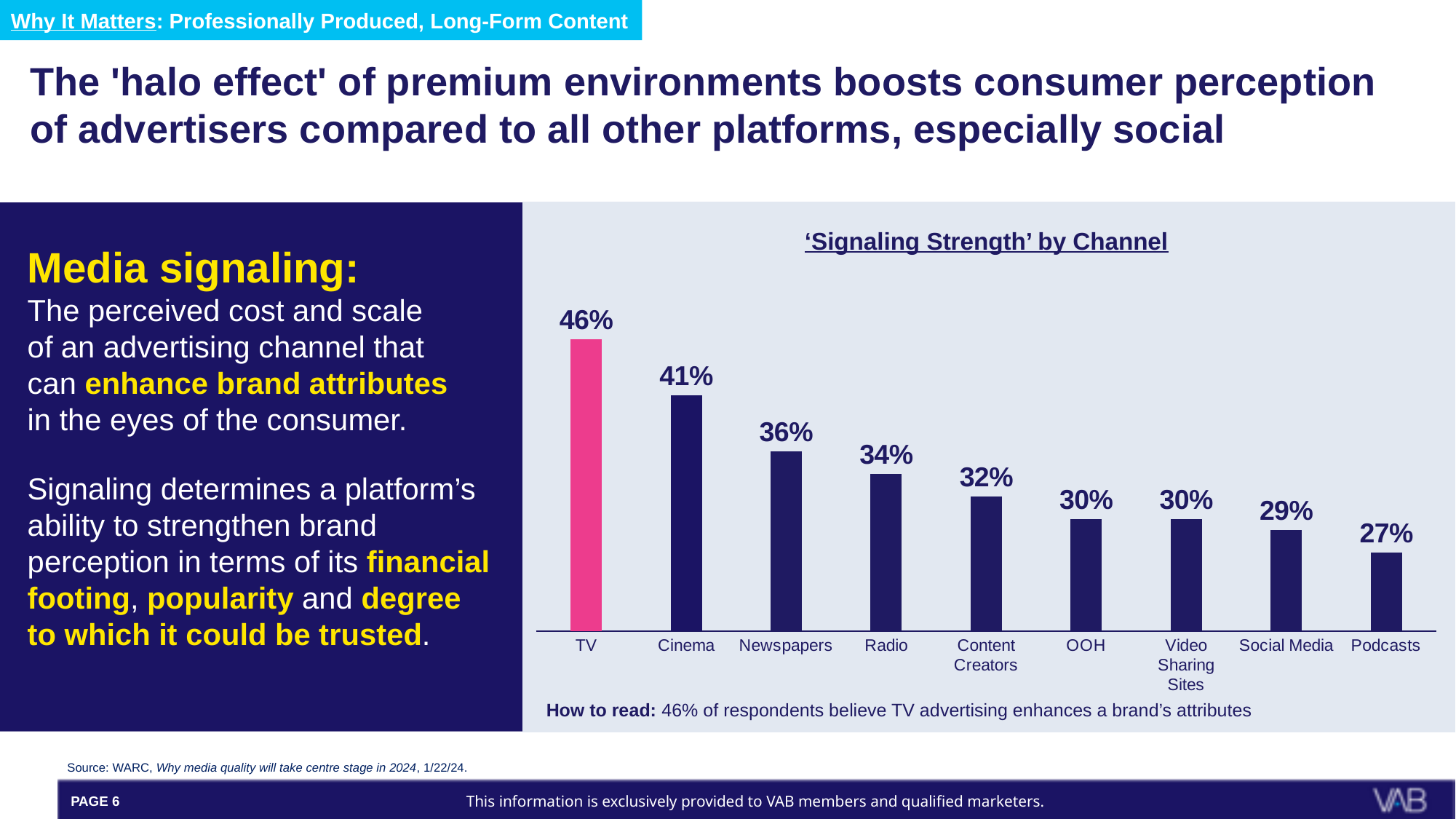
What is the difference in signaling strength between Cinema and Newspapers? 5% What is the signaling strength value for Cinema? 41% What is the signaling strength value for Podcasts? 27% What is the signaling strength value for TV? 46% What is the difference in signaling strength between TV and Social Media? 17% Which has a higher signaling strength, Radio or OOH? Radio Which bar in the chart is coloured pink rather than dark navy? TV What is the signaling strength value for Content Creators? 32% Which channel has the lowest signaling strength? Podcasts Which channel has the highest signaling strength? TV What type of chart is used to show 'Signaling Strength' by Channel? Bar chart How many channels are shown in the chart? 9